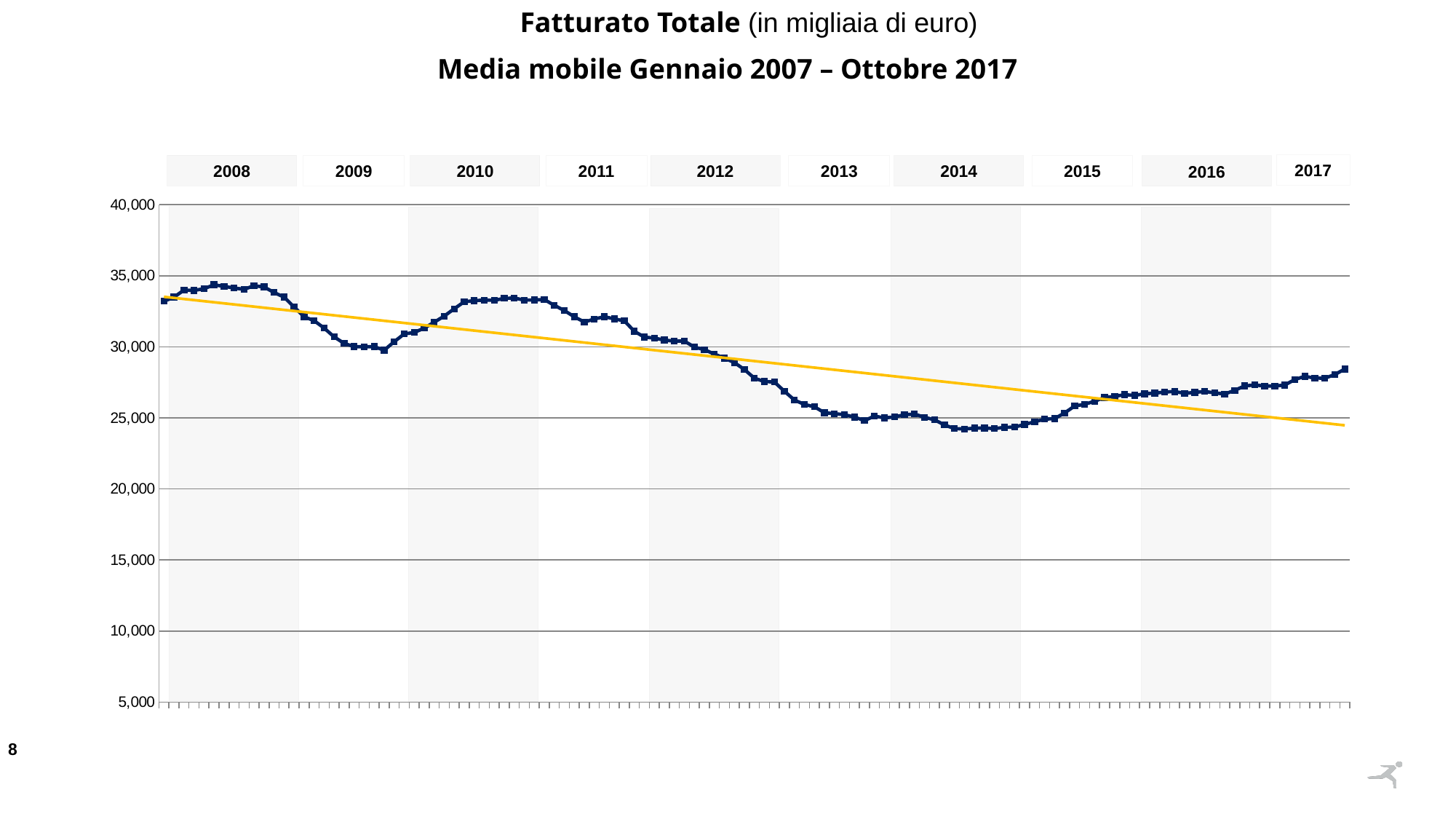
How many year labels are shown along the top of the chart? 10 Does the moving-average line rise or fall from the start of 2015 to the end of 2017? rise Is the moving-average value at the start of 2008 greater or less than 30,000? greater What kind of chart is shown on the slide? line chart Is the moving-average value at the end of 2017 greater or less than 25,000? greater Does the yellow trend line rise or fall across the chart? fall Which year band contains the lowest point of the moving-average line? 2014 What is the highest value shown on the vertical axis? 40,000 Is the moving-average value in the middle of 2010 greater or less than 30,000? greater What is the title of the chart? Fatturato Totale (in migliaia di euro) – Media mobile Gennaio 2007 – Ottobre 2017 Does the moving-average line rise or fall overall from 2008 to 2014? fall